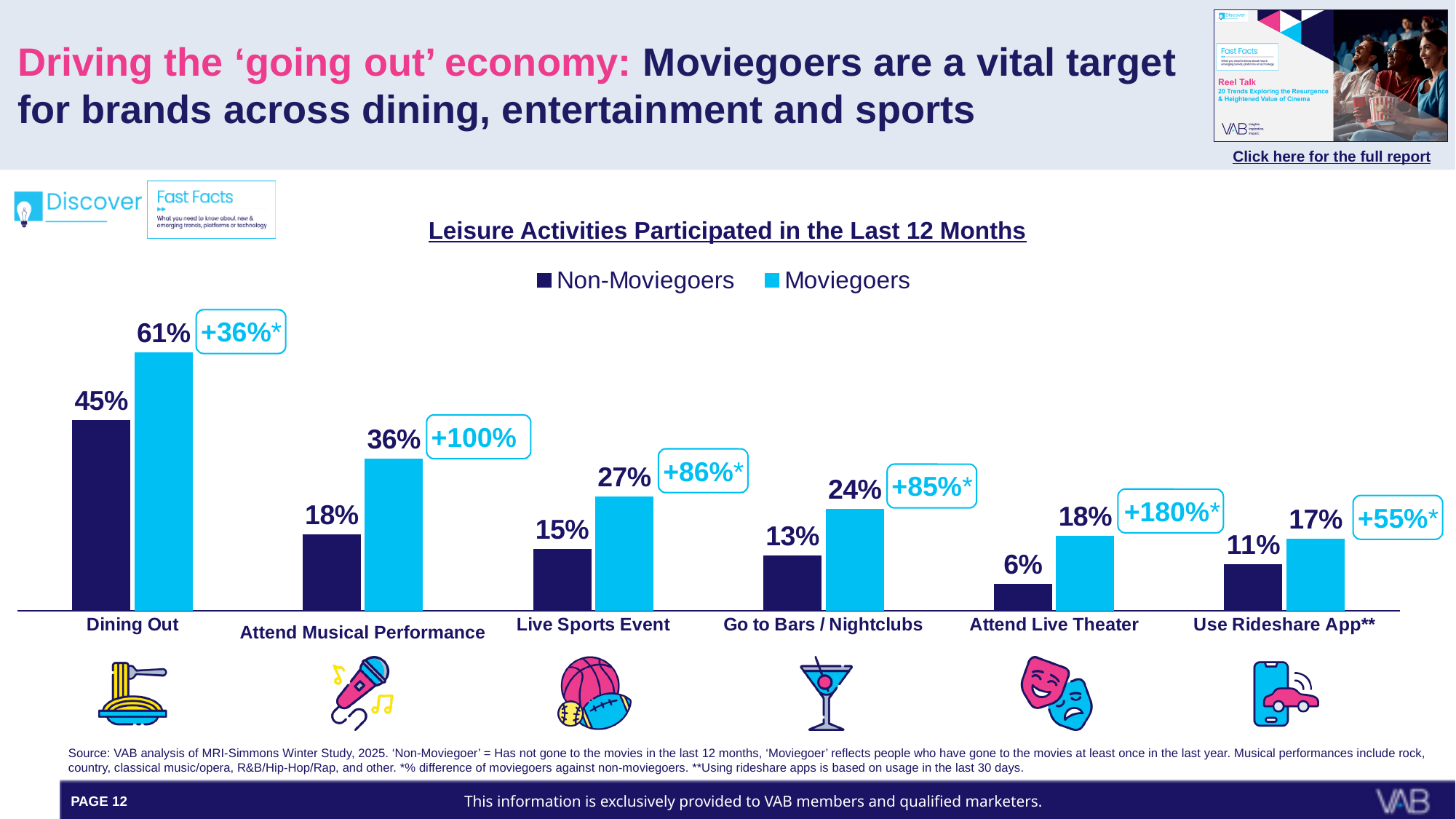
Which activity has the lowest value for Non-Moviegoers? Attend Live Theater What percentage difference is shown for Moviegoers against Non-Moviegoers for Attend Live Theater? +180%* How many series does the legend list? 2 What is the value for Non-Moviegoers for Attend Live Theater? 6% What is the difference between Moviegoers and Non-Moviegoers for Attend Musical Performance? 18% What is the title of the chart? Leisure Activities Participated in the Last 12 Months What kind of chart is shown on the slide? Bar chart What percentage of Moviegoers participated in Dining Out in the last 12 months? 61% How many leisure activity categories are shown on the chart? 6 Which activity has the highest value for Moviegoers? Dining Out What percentage of Non-Moviegoers attended a Live Sports Event? 15% Which is larger: the Moviegoers value for Go to Bars / Nightclubs or the Moviegoers value for Use Rideshare App**? Go to Bars / Nightclubs